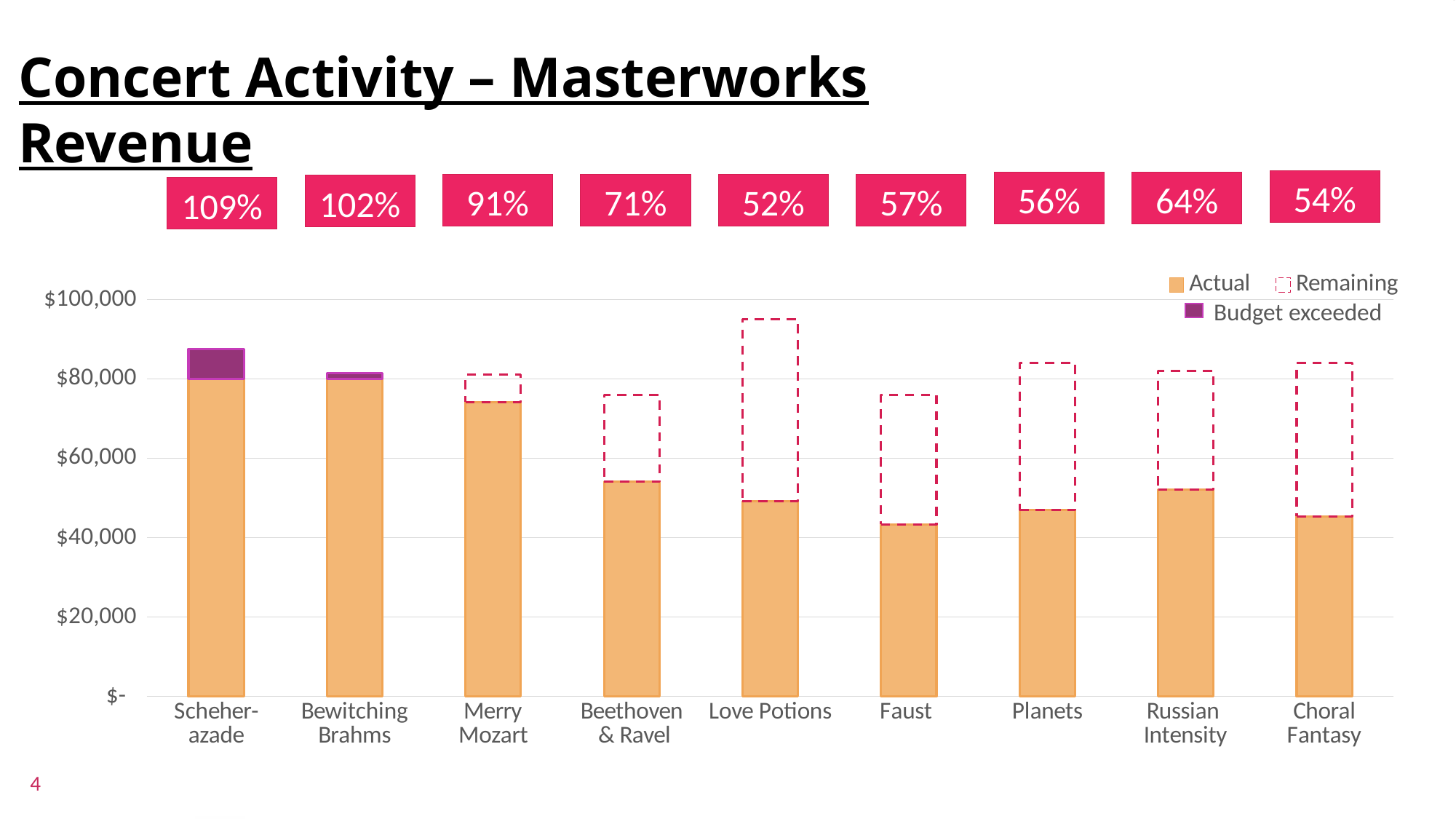
How many concerts are shown along the x axis of the chart? 9 What percentage is shown above the Love Potions bar? 52% Which concert has the highest percentage shown above its bar? Scheherazade What kind of chart is shown on the slide? bar chart Is the Actual value for Faust greater or less than $60,000? less How many series does the chart's legend list? 3 How many concerts show a Budget exceeded segment on their bar? 2 What percentage is shown above the Scheherazade bar? 109% Which concert has the lowest percentage shown above its bar? Love Potions Is the Actual value for Merry Mozart greater or less than $60,000? greater What percentage is shown above the Russian Intensity bar? 64% Which has the larger percentage shown above its bar, Faust or Planets? Faust